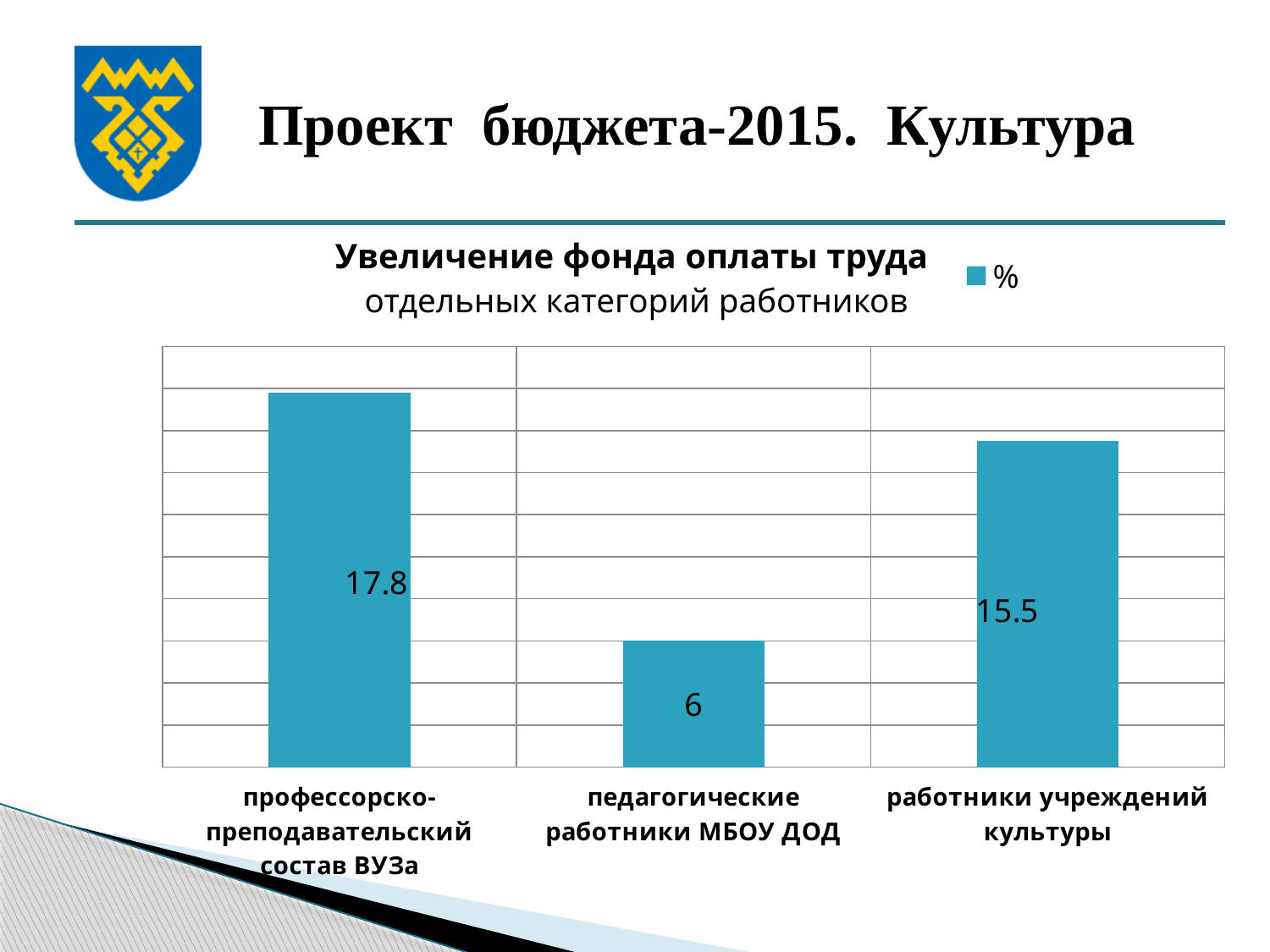
What is the legend entry of the chart? % How many series does the legend list? 1 What kind of chart is shown on the slide? bar chart Which category has the highest value? профессорско-преподавательский состав ВУЗа What is the value for работники учреждений культуры? 15.5 What is the difference between the values for профессорско-преподавательский состав ВУЗа and работники учреждений культуры? 2.3 What is the difference between the values for работники учреждений культуры and педагогические работники МБОУ ДОД? 9.5 Which is larger: the value for педагогические работники МБОУ ДОД or the value for работники учреждений культуры? работники учреждений культуры What is the value for педагогические работники МБОУ ДОД? 6 How many categories are shown in the chart? 3 What is the value for профессорско-преподавательский состав ВУЗа? 17.8 Which category has the lowest value? педагогические работники МБОУ ДОД